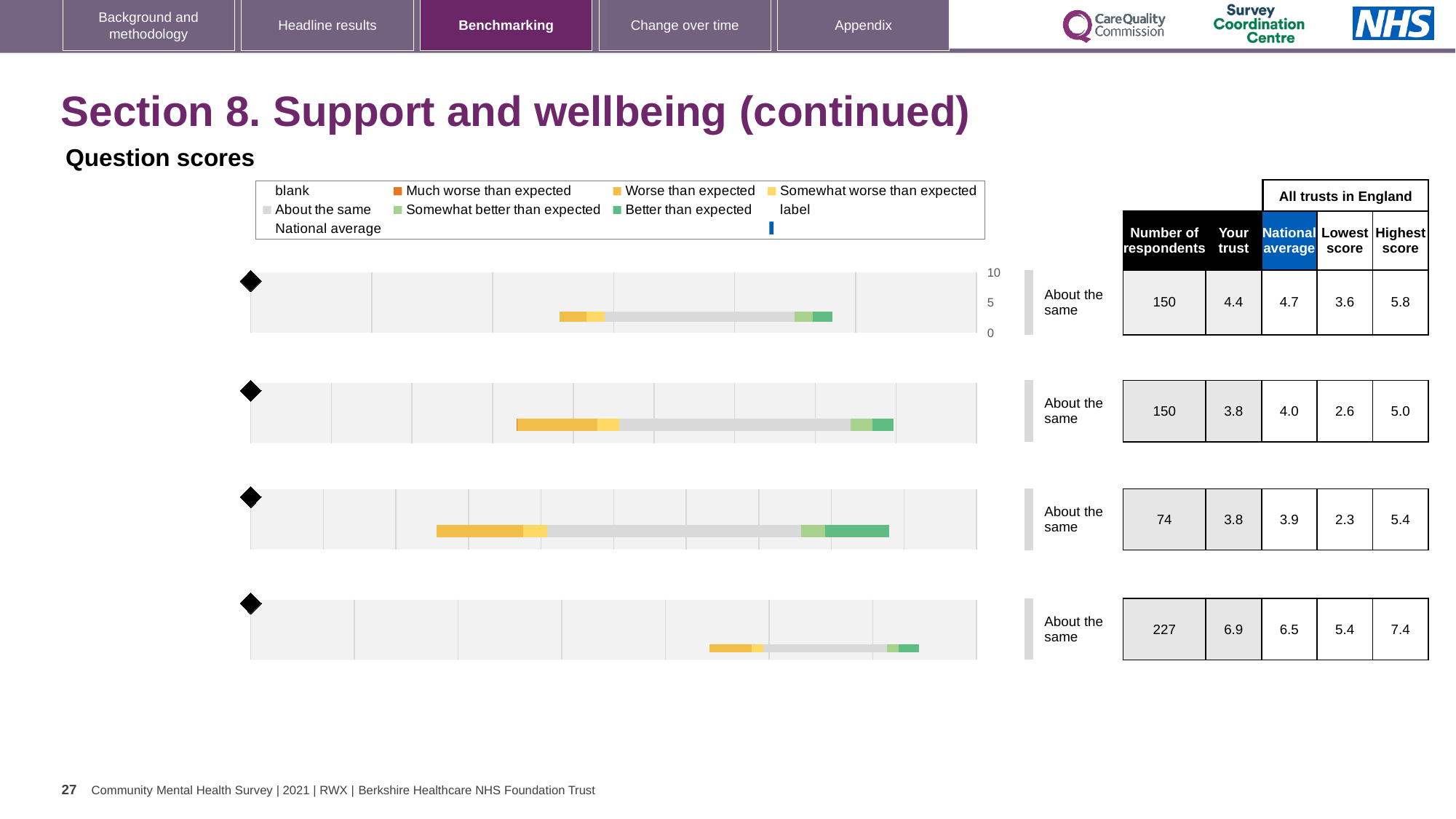
For the third chart row, what is the highest score among all trusts in England? 5.4 What is the highest value shown on the vertical axis next to the first (top) chart? 10 Which chart row has the highest 'Your trust' score? the fourth (bottom) row For the first (top) chart row, what is the 'Your trust' score in the table? 4.4 For the fourth (bottom) chart row, how many respondents are listed in the table? 227 How many benchmarking charts are shown on the slide? 4 What kind of chart is used for each of the four benchmarking rows on the slide? bar chart For the first (top) chart row, what is the national average in the table? 4.7 For the fourth (bottom) chart row, which is larger: the 'Your trust' score or the national average? Your trust What benchmark category is shown beside every one of the four chart rows? About the same For the first (top) chart row, what is the difference between the highest score (5.8) and the lowest score (3.6)? 2.2 In the legend, what colour represents 'Better than expected'? green